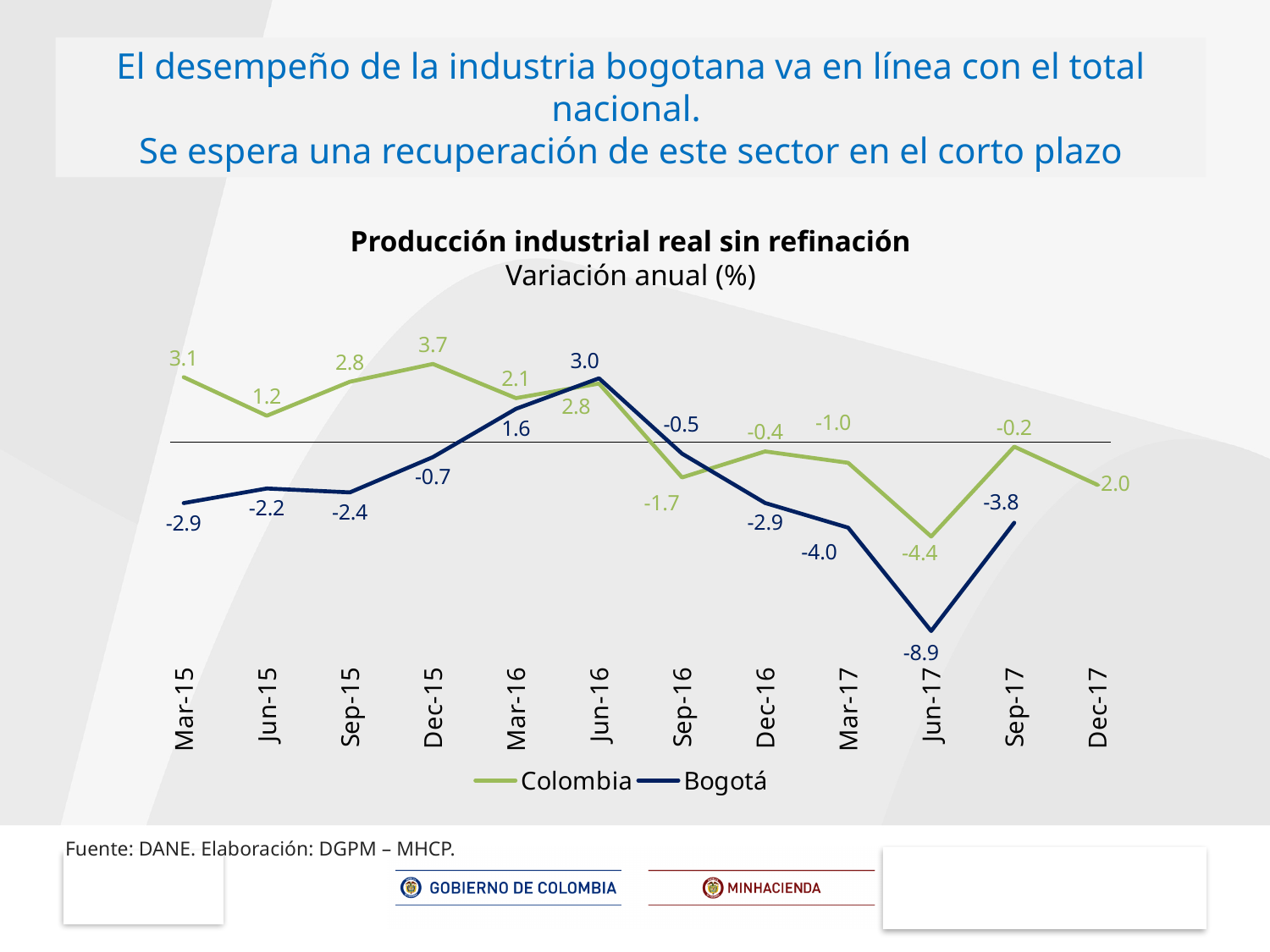
In which period does the Colombia series reach its highest value? Dec-15 What kind of chart is shown on the slide? line chart What is the difference between the Bogotá and Colombia values in Jun-16? 0.2 What is the value for Colombia in Dec-15? 3.7 What is the value for Bogotá in Mar-16? 1.6 In which period does the Bogotá series reach its lowest value? Jun-17 How many time points are shown on the x axis? 12 How many series does the legend list? 2 Does the Bogotá series rise or fall from Mar-15 to Jun-16? rise What is the value for Bogotá in Jun-17? -8.9 What is the title of the chart? Producción industrial real sin refinación In Mar-15, which series has the higher value, Colombia or Bogotá? Colombia